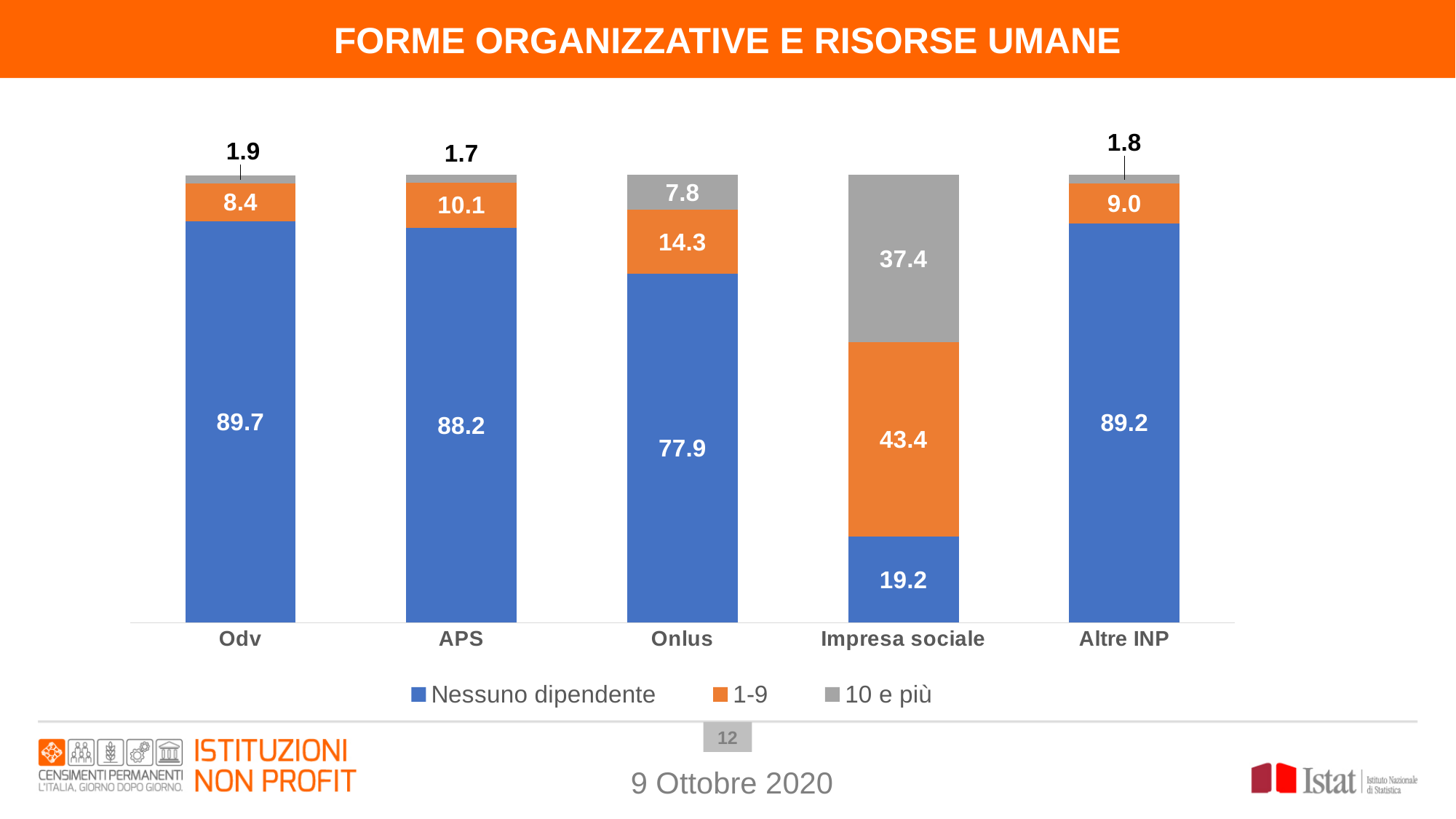
What is the value of '10 e più' for APS? 1.7 Which category has the highest value for 'Nessuno dipendente'? Odv Which category has the highest value for '10 e più'? Impresa sociale Which is larger: the '1-9' value for APS or the '1-9' value for Altre INP? APS Which category has the lowest value for 'Nessuno dipendente'? Impresa sociale How many series does the legend list? 3 What is the value of '1-9' for Impresa sociale? 43.4 What kind of chart is shown on the slide? Stacked bar chart How many categories are shown on the x axis? 5 What is the difference between the '1-9' values for Onlus and Odv? 5.9 What is the value of '1-9' for Altre INP? 9.0 What is the value of 'Nessuno dipendente' for Onlus? 77.9